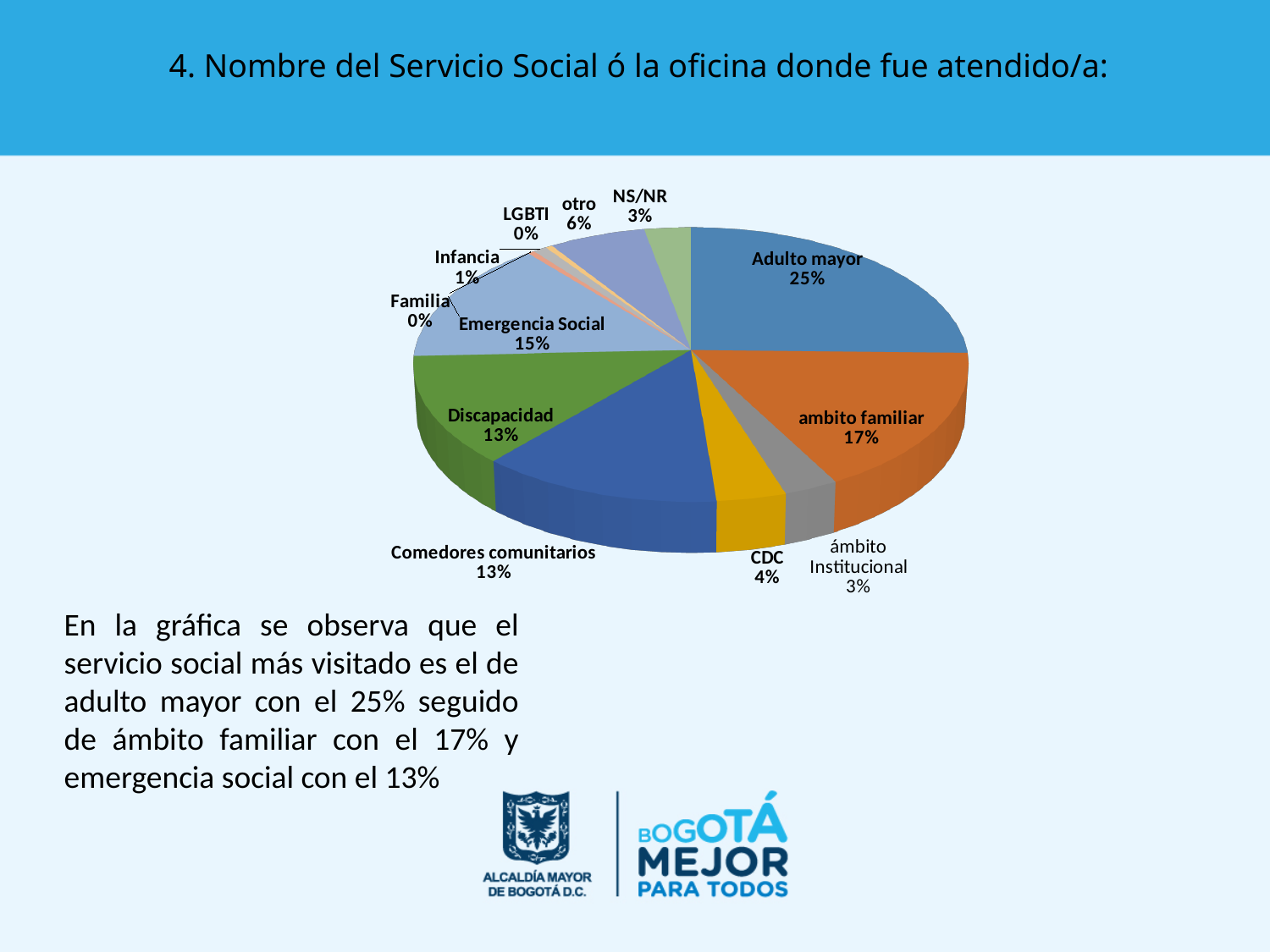
What type of chart is shown on the slide? Pie chart Which slice is larger, Emergencia Social or Discapacidad? Emergencia Social What percentage is shown for Emergencia Social? 15% What percentage of the pie chart does the Adulto mayor slice represent? 25% What percentage is shown for NS/NR? 3% What is the difference in percentage points between Adulto mayor and ambito familiar? 8 What percentage is shown for Infancia? 1% What is the value shown for ambito familiar in the pie chart? 17% How many categories are shown in the pie chart? 12 Which category has the largest slice of the pie chart? Adulto mayor What is the title of the chart on the slide? 4. Nombre del Servicio Social ó la oficina donde fue atendido/a: What value is labelled for CDC in the pie chart? 4%